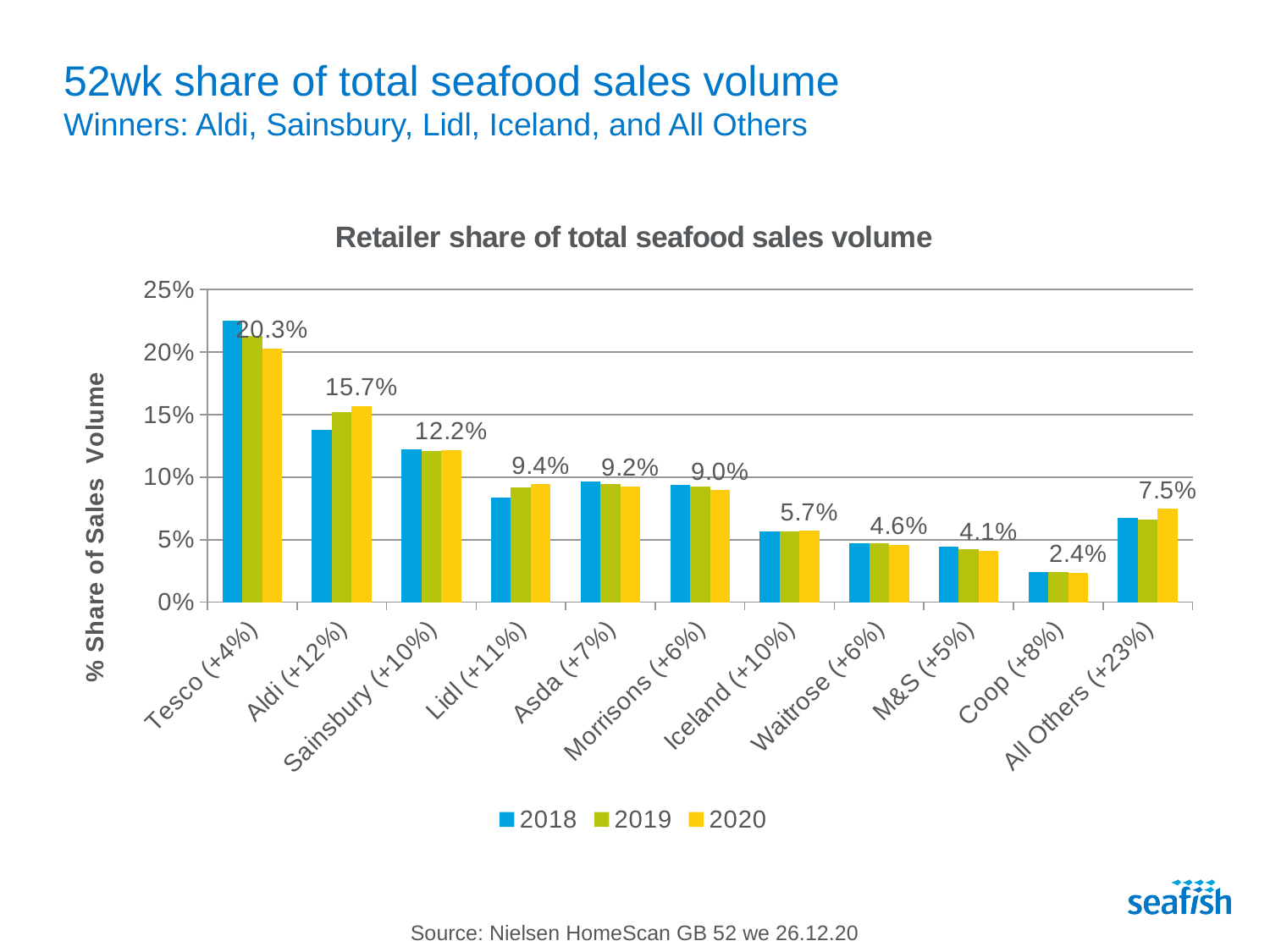
What kind of chart is shown on the slide? Bar chart What is the 2020 value for Aldi (+12%)? 15.7% What is the 2020 share of total seafood sales volume for Tesco (+4%)? 20.3% How many series does the legend list? 3 Which retailer has the lowest 2020 share of seafood sales volume? Coop (+8%) What is the difference between the 2020 values for Tesco (+4%) and Aldi (+12%)? 4.6% Which retailer has the highest 2020 share of seafood sales volume? Tesco (+4%) What is the 2020 value for All Others (+23%)? 7.5% Which has the larger 2020 value, Sainsbury (+10%) or Lidl (+11%)? Sainsbury (+10%) How many retailer categories are shown on the x axis? 11 Is the 2018 value for Tesco (+4%) greater or less than 20%? greater Is the 2018 value for Aldi (+12%) greater or less than 15%? less